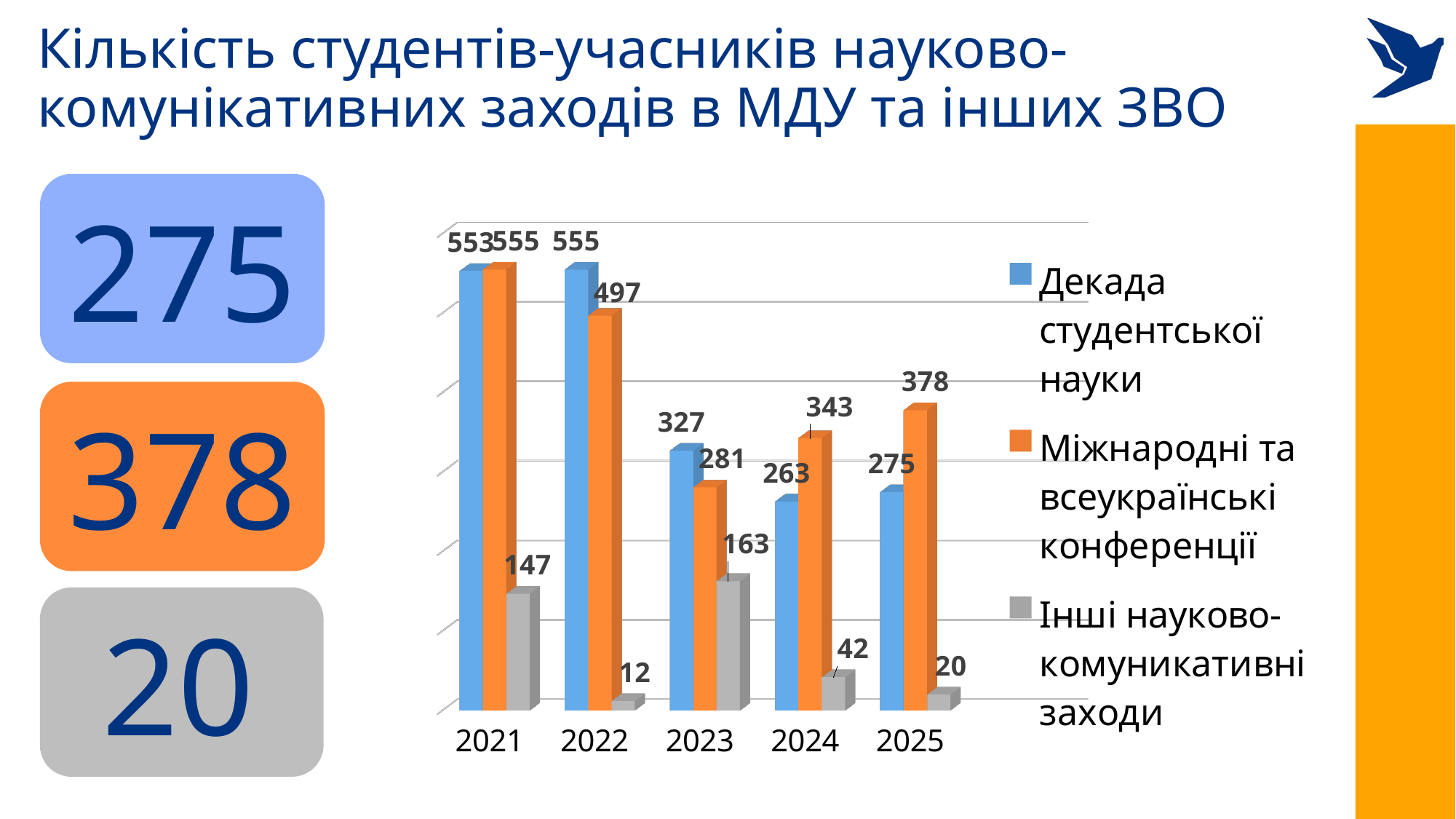
In which year is the value for Декада студентської науки the highest? 2022 Does the value for Інші науково-комунікативні заходи rise or fall from 2023 to 2025? Fall What is the value for Міжнародні та всеукраїнські конференції in 2024? 343 Which is larger in 2022: Декада студентської науки or Міжнародні та всеукраїнські конференції? Декада студентської науки How many years are shown on the x axis of the chart? 5 What is the value for Декада студентської науки in 2023? 327 Which colour represents Міжнародні та всеукраїнські конференції in the chart? Orange What is the value for Інші науково-комунікативні заходи in 2021? 147 How many series does the chart legend list? 3 What kind of chart is shown on the slide? Bar chart In which year is the value for Інші науково-комунікативні заходи the lowest? 2022 What is the difference between the Міжнародні та всеукраїнські конференції values for 2025 and 2024? 35